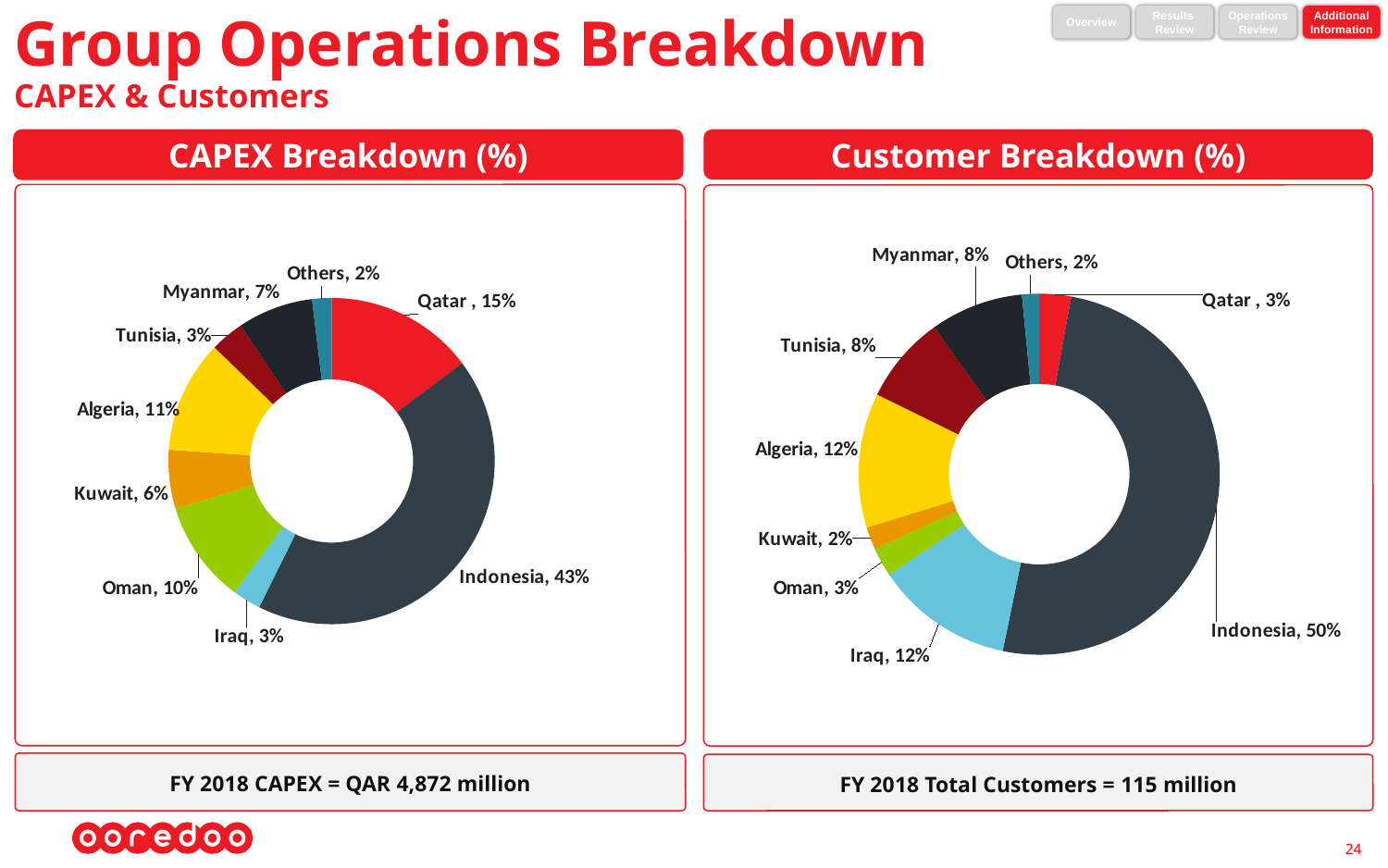
In the Customer Breakdown (%) chart, what is the value for Iraq? 12% In the Customer Breakdown (%) chart, which is larger, Algeria or Tunisia? Algeria In the Customer Breakdown (%) chart, what is the combined share of Myanmar and Tunisia? 16% In the CAPEX Breakdown (%) chart, what is the difference between Indonesia and Qatar? 28% What is the title of the chart on the right side of the slide? Customer Breakdown (%) In the CAPEX Breakdown (%) chart, which category has the smallest share? Others What kind of chart is the CAPEX Breakdown (%) chart? Doughnut chart In the CAPEX Breakdown (%) chart, which is larger, Oman or Kuwait? Oman How many categories are shown in the Customer Breakdown (%) chart? 9 In the Customer Breakdown (%) chart, which category has the largest share? Indonesia In the CAPEX Breakdown (%) chart, what is the value for Indonesia? 43% In the CAPEX Breakdown (%) chart, what is the value for Qatar? 15%